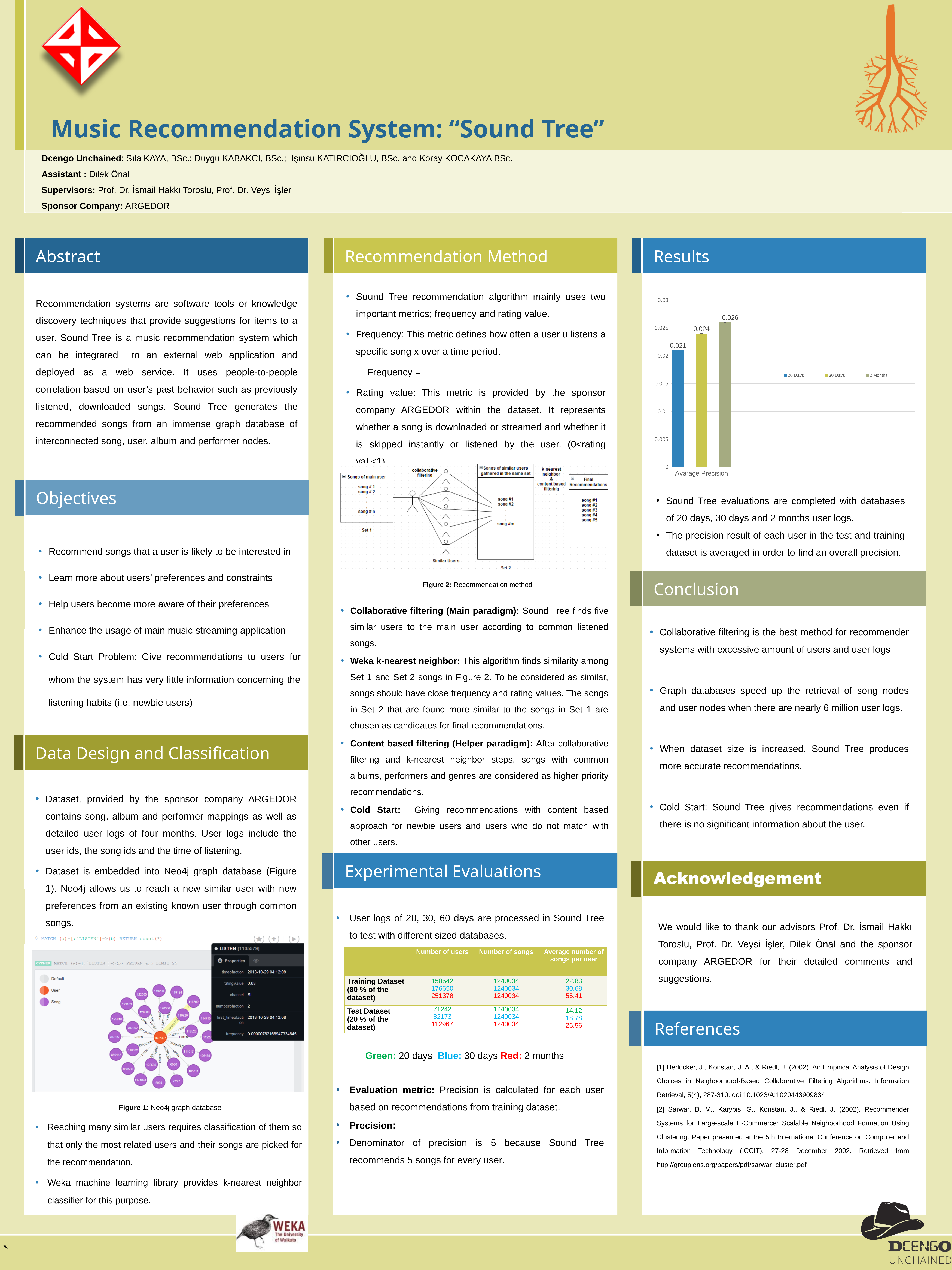
In the Results chart, what is the average precision for 2 Months? 0.026 In the Results chart, what is the average precision for 30 Days? 0.024 In the Results chart, what is the difference between the average precision for 2 Months and for 20 Days? 0.005 What is the label on the category axis of the Results chart? Avarage Precision In the Results chart, what is the average precision for 20 Days? 0.021 In the Results chart, is the value for 20 Days greater or less than 0.025? less How many series does the legend of the Results chart list? 3 In the Results chart, which series has the highest average precision? 2 Months In the Results chart, what is the difference between the average precision for 30 Days and for 20 Days? 0.003 In the Results chart, which series has the lowest average precision? 20 Days What kind of chart is shown in the Results section? bar chart In the Results chart, which is larger, the average precision for 30 Days or for 2 Months? 2 Months